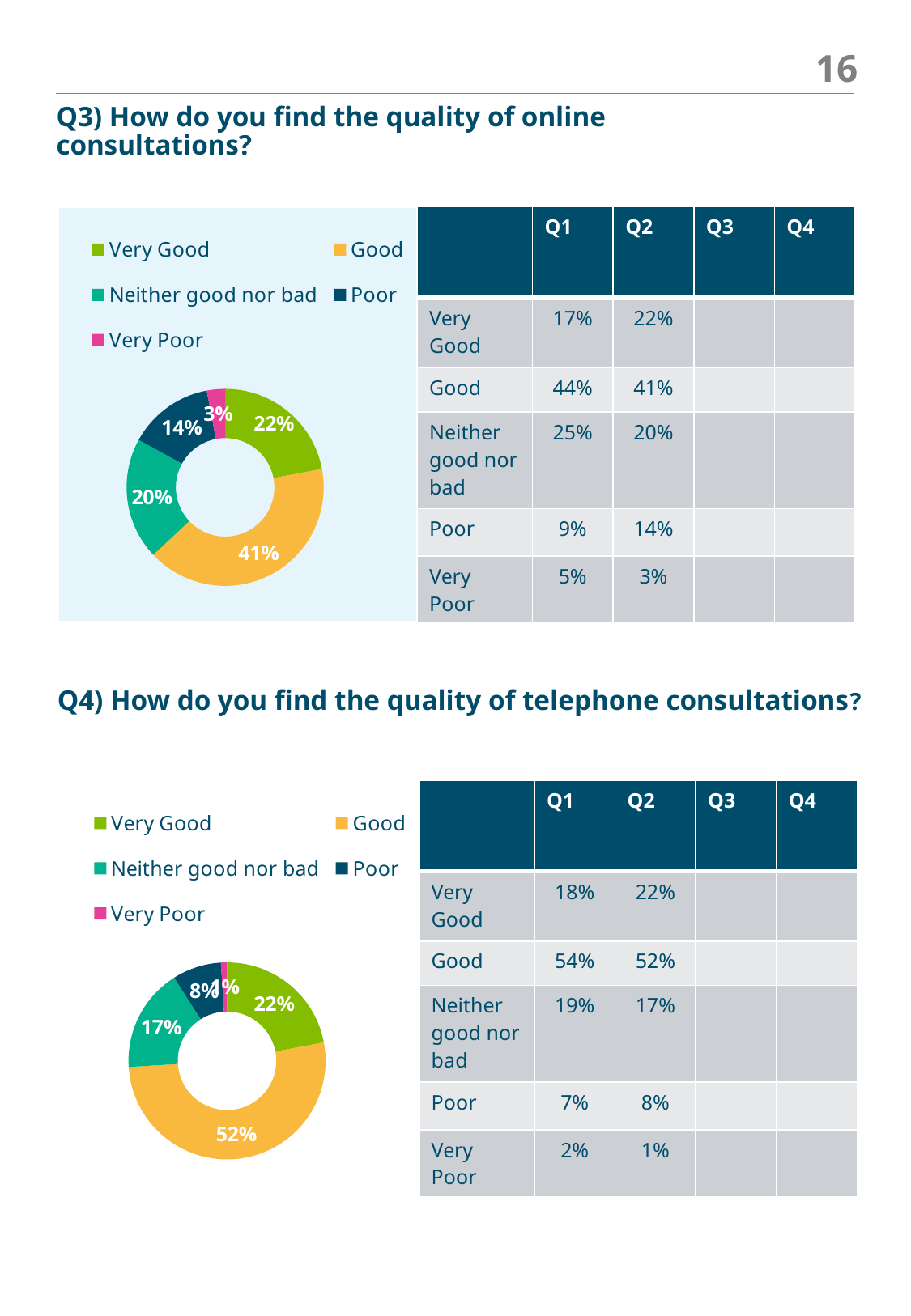
In the top chart (Q3, online consultations), which category has the smallest slice? Very Poor In the top chart (Q3, online consultations), what is the difference between the Good and Very Good slices? 19% In the bottom chart (Q4, telephone consultations), what share of the pie is labelled Good? 52% In the top chart (Q3, online consultations), how many categories does the legend list? 5 In the top chart (Q3, online consultations), what share of the pie is labelled Poor? 14% In the bottom chart (Q4, telephone consultations), which colour represents Very Poor in the legend? Pink In the bottom chart (Q4, telephone consultations), what share of the pie is labelled Neither good nor bad? 17% In the top chart (Q3, online consultations), which category has the largest slice? Good In the bottom chart (Q4, telephone consultations), which is larger, the Very Good slice or the Neither good nor bad slice? Very Good In the top chart (Q3, online consultations), what share of the pie is labelled Good? 41% What kind of chart is used on the slide for Q3 and Q4? Doughnut chart In the bottom chart (Q4, telephone consultations), what is the difference between the Good and Very Good slices? 30%